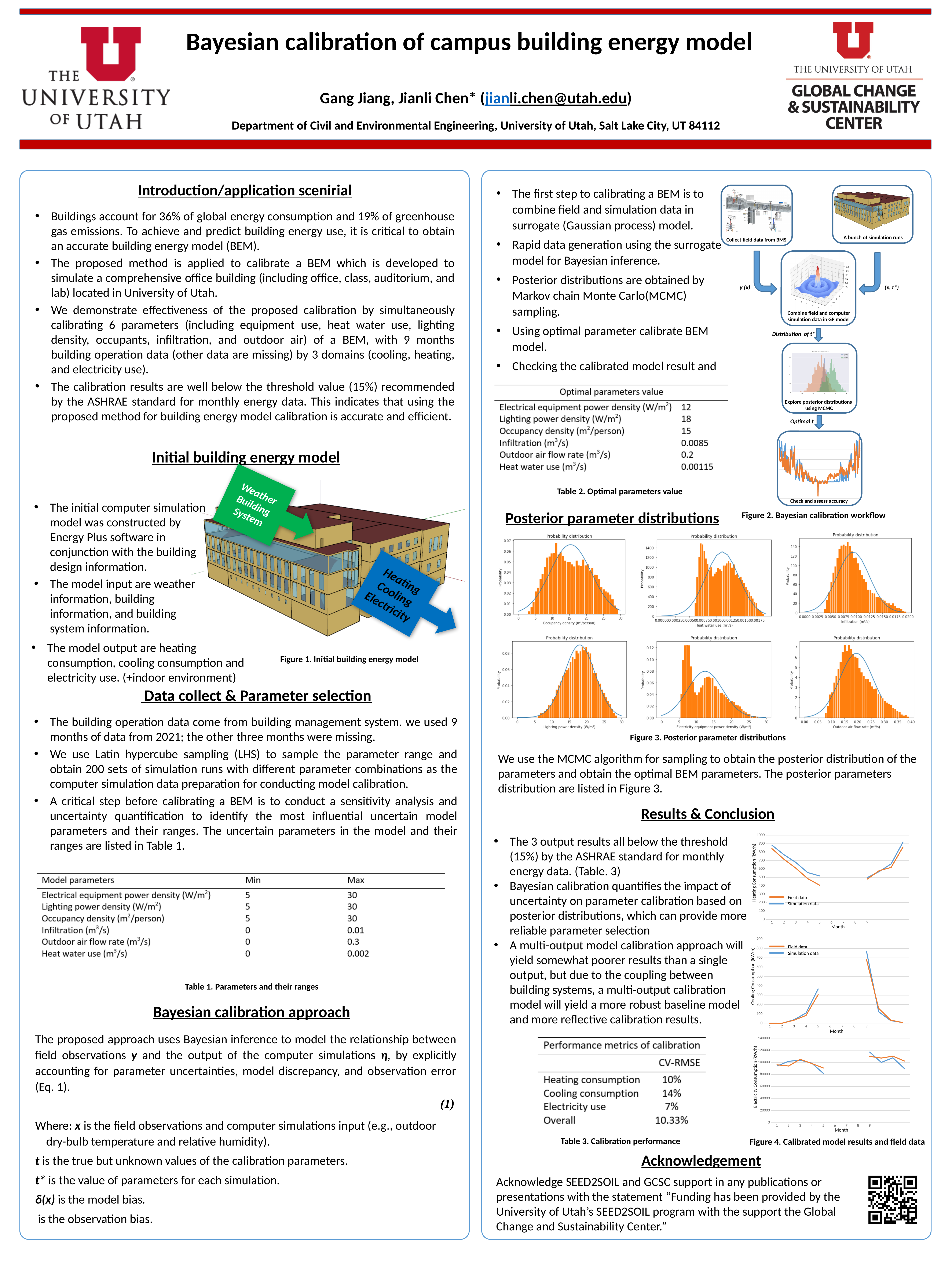
In Figure 4, does the Heating Consumption Field data rise or fall from month 1 to month 5? fall In Figure 4, what are the two legend entries of the Cooling Consumption chart? Field data, Simulation data In Figure 4, is the Field data value for Heating Consumption at month 5 greater or less than 800? less In Figure 3, what kind of chart is used for each posterior parameter distribution panel? bar chart In Figure 4, is the Field data value for Electricity Consumption at month 1 greater or less than 60000? greater In Figure 4, is the Field data value for Heating Consumption at month 1 greater or less than 500? greater In Figure 4, what kind of chart is the Heating Consumption chart? line chart In Figure 3 (Posterior parameter distributions), how many distribution panels are shown? 6 In Figure 4, how many series does the legend of the Heating Consumption chart list? 2 In Figure 4, what is the y-axis label of the Cooling Consumption chart? Cooling Consumption (kW/h)